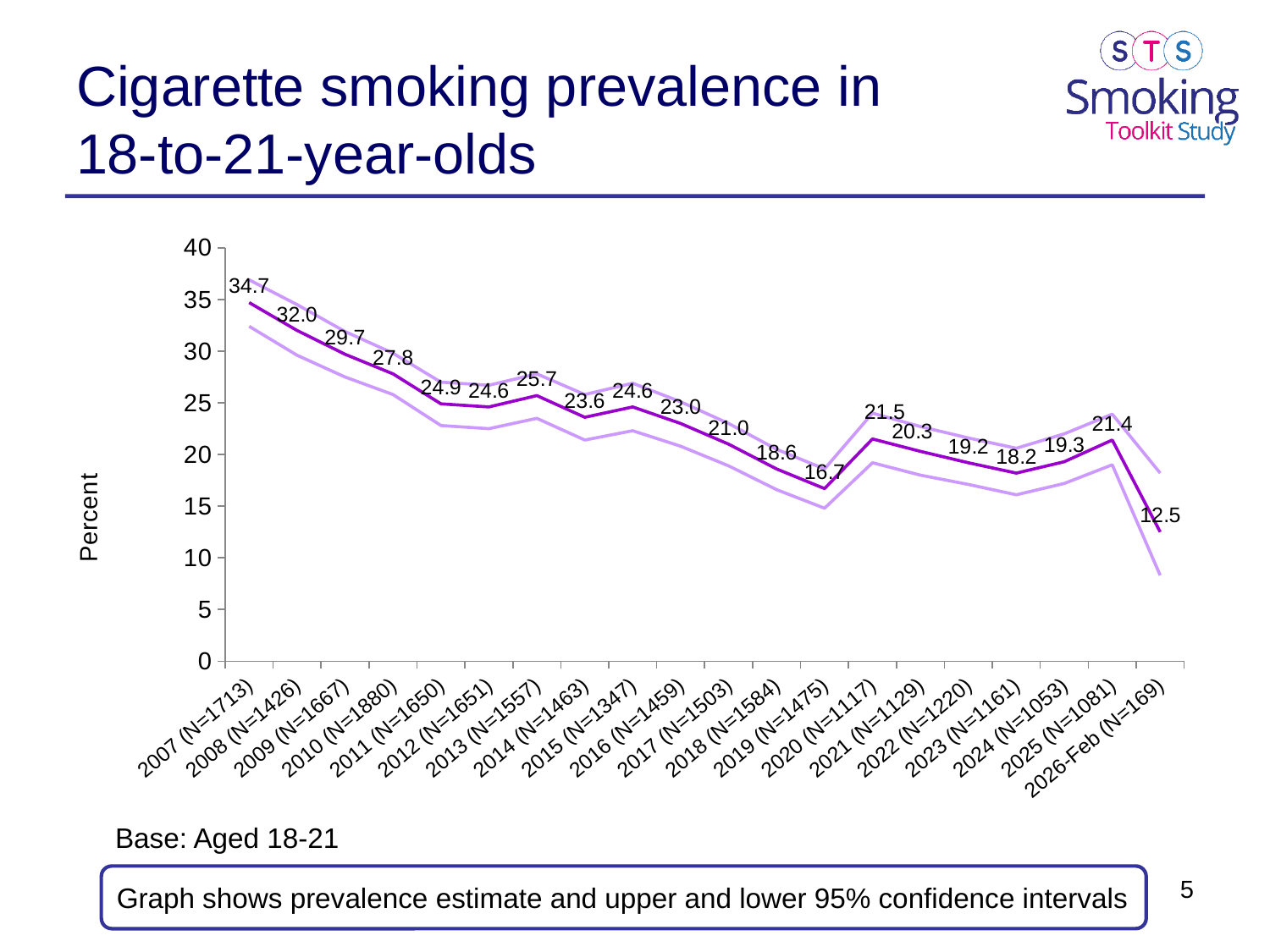
What is the difference between the prevalence estimates for 2020 and 2019? 4.8 Is the upper confidence interval value for 2007 greater or less than 35? greater What is the cigarette smoking prevalence estimate for 2007? 34.7 Which time point has the lowest prevalence estimate? 2026-Feb How many time points are plotted on the x axis? 20 What is the difference between the prevalence estimates for 2007 and 2026-Feb? 22.2 What is the prevalence estimate for 2019? 16.7 What type of chart is shown on the slide? Line chart Which is larger, the prevalence estimate for 2013 or for 2014? 2013 Does the prevalence estimate generally rise or fall from 2007 to 2026-Feb? Fall What is the prevalence estimate for 2026-Feb? 12.5 Which year has the highest prevalence estimate? 2007